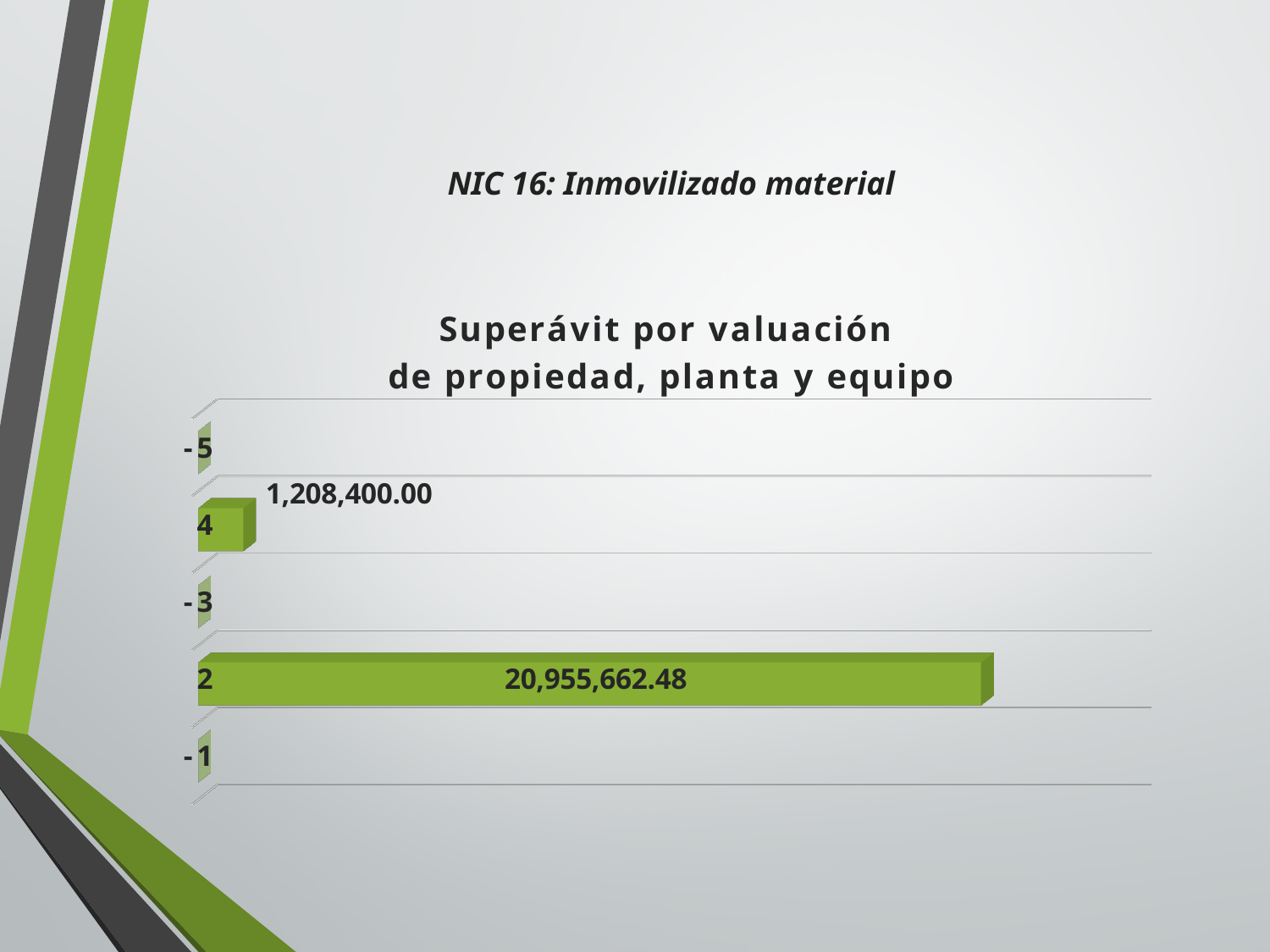
What data label is shown for category 3? -3 How many categories are shown on the chart's axis? 5 What kind of chart is shown on the slide? Bar chart What is the value for category 4 in the chart? 1,208,400.00 What is the value for category 2 in the chart? 20,955,662.48 What colour are the bars in the chart? Green Which category has the highest value in the chart? 2 What is the difference between the values for category 2 and category 4? 19,747,262.48 Which is larger, the value for category 2 or the value for category 4? Category 2 What is the title of the chart? Superávit por valuación de propiedad, planta y equipo